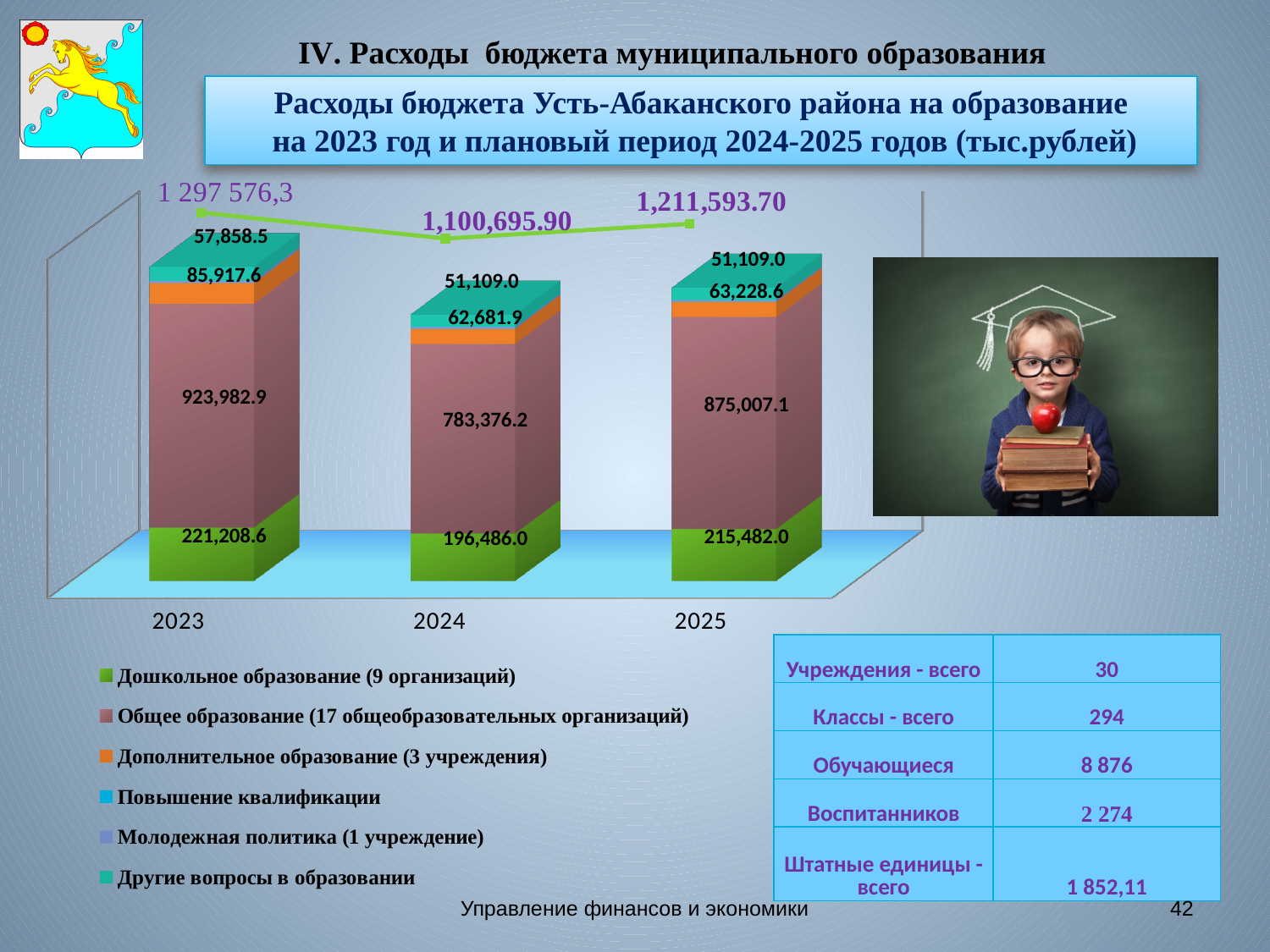
Does the total on the line rise or fall from 2023 to 2024? fall How many series does the legend list? 6 What is the total shown on the line for 2025? 1,211,593.70 What is the value for Дошкольное образование in 2024? 196,486.0 Which year has the highest total on the line? 2023 What is the difference between the Общее образование values for 2023 and 2024? 140,606.7 How many years are shown on the x axis? 3 What kind of chart is shown? Stacked bar chart with a line Which year has the lowest value for Общее образование? 2024 Which is larger: Дошкольное образование in 2023 or in 2025? 2023 What is the value for Дополнительное образование in 2025? 63,228.6 What is the value for Общее образование in 2023? 923,982.9